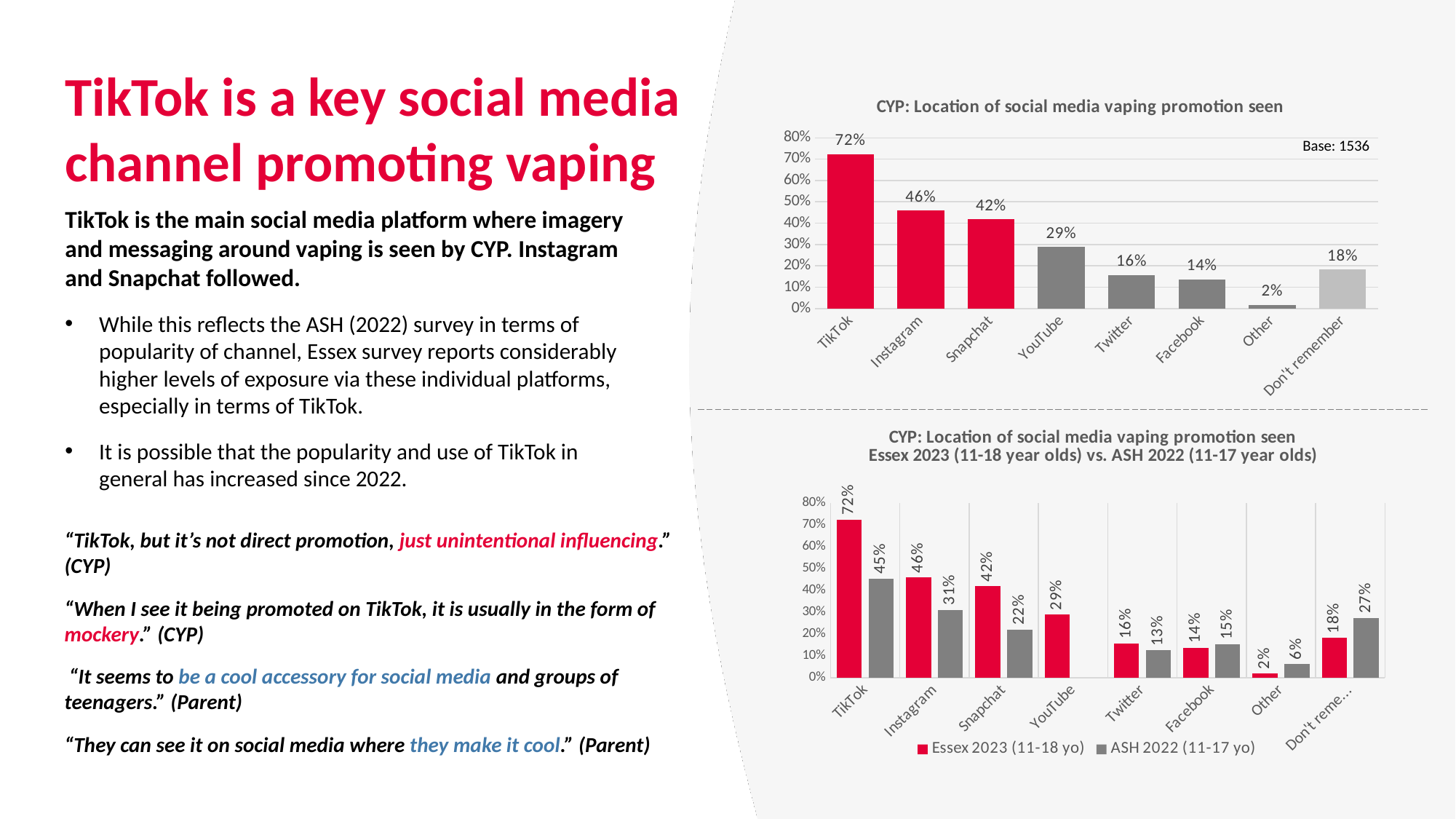
What type of chart is the bottom chart comparing Essex 2023 vs. ASH 2022? Bar chart In the bottom chart comparing Essex 2023 vs. ASH 2022, what is the ASH 2022 value for Don't remember? 27% In the top chart 'CYP: Location of social media vaping promotion seen', which category has the lowest value? Other In the top chart 'CYP: Location of social media vaping promotion seen', what is the value for TikTok? 72% In the top chart 'CYP: Location of social media vaping promotion seen', what is the value for YouTube? 29% In the top chart 'CYP: Location of social media vaping promotion seen', what is the difference between Instagram and Snapchat? 4% In the bottom chart comparing Essex 2023 vs. ASH 2022, what is the ASH 2022 value for Instagram? 31% In the bottom chart comparing Essex 2023 vs. ASH 2022, what is the difference between the Essex 2023 and ASH 2022 values for TikTok? 27% In the top chart 'CYP: Location of social media vaping promotion seen', how many categories are shown on the x axis? 8 In the top chart 'CYP: Location of social media vaping promotion seen', what base size is shown? Base: 1536 In the bottom chart comparing Essex 2023 vs. ASH 2022, how many series does the legend list? 2 In the bottom chart comparing Essex 2023 vs. ASH 2022, which is larger for Facebook: Essex 2023 or ASH 2022? ASH 2022